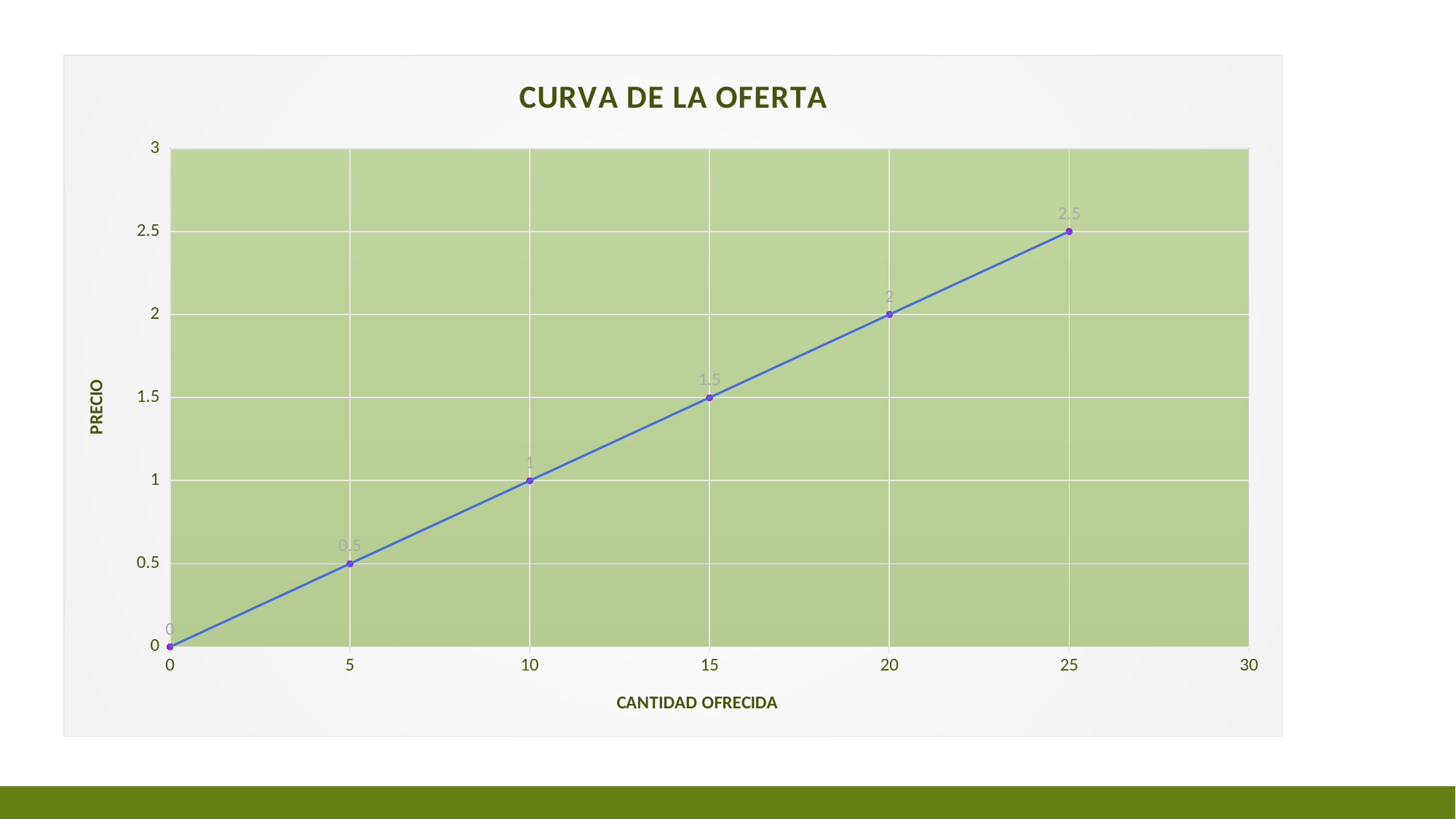
At which CANTIDAD OFRECIDA value is PRECIO lowest? 0 Which has a higher PRECIO: CANTIDAD OFRECIDA 15 or CANTIDAD OFRECIDA 20? CANTIDAD OFRECIDA 20 What is the PRECIO value when CANTIDAD OFRECIDA is 10? 1 What is the PRECIO value when CANTIDAD OFRECIDA is 5? 0.5 What is the title of the chart? CURVA DE LA OFERTA Does PRECIO rise or fall as CANTIDAD OFRECIDA increases? rise What is the PRECIO value when CANTIDAD OFRECIDA is 0? 0 What is the PRECIO value when CANTIDAD OFRECIDA is 25? 2.5 What type of chart is shown on the slide? line chart How many data points are plotted on the line? 6 At which CANTIDAD OFRECIDA value is PRECIO highest? 25 What is the difference in PRECIO between CANTIDAD OFRECIDA 20 and CANTIDAD OFRECIDA 5? 1.5